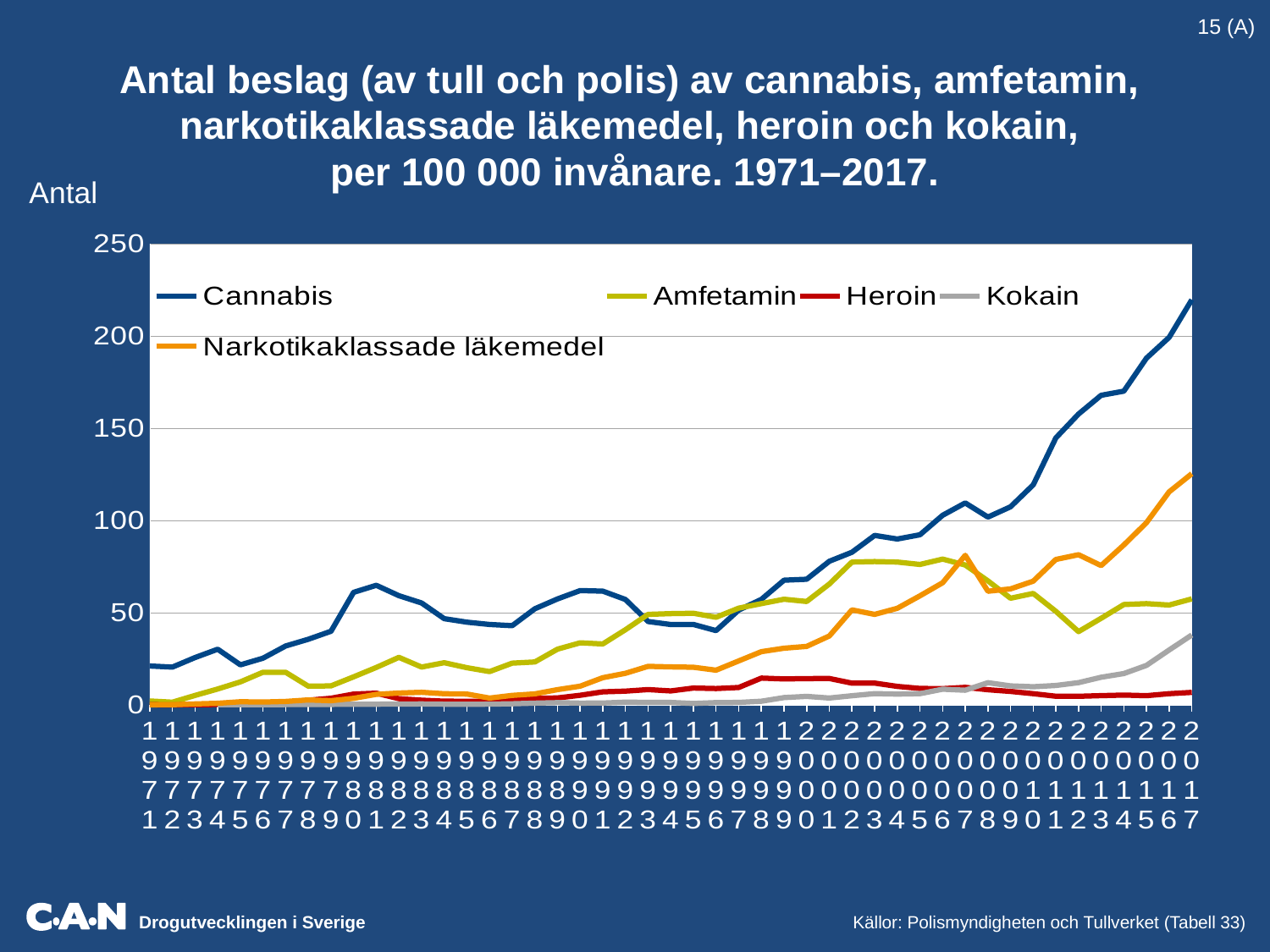
Is the value for Cannabis in 1971 greater or less than 50? less Does the Cannabis line rise or fall from 2010 to 2017? rise Which series has the highest value in 2017? Cannabis What kind of chart is shown on the slide? line chart What label is shown on the y axis? Antal How many years are plotted along the x axis? 47 Is the value for Narkotikaklassade läkemedel in 2017 greater or less than 100? greater How many series does the legend list? 5 Which series has the lowest value in 2017? Heroin Is the value for Kokain in 2017 greater or less than 50? less In 2017, which is larger: Narkotikaklassade läkemedel or Amfetamin? Narkotikaklassade läkemedel